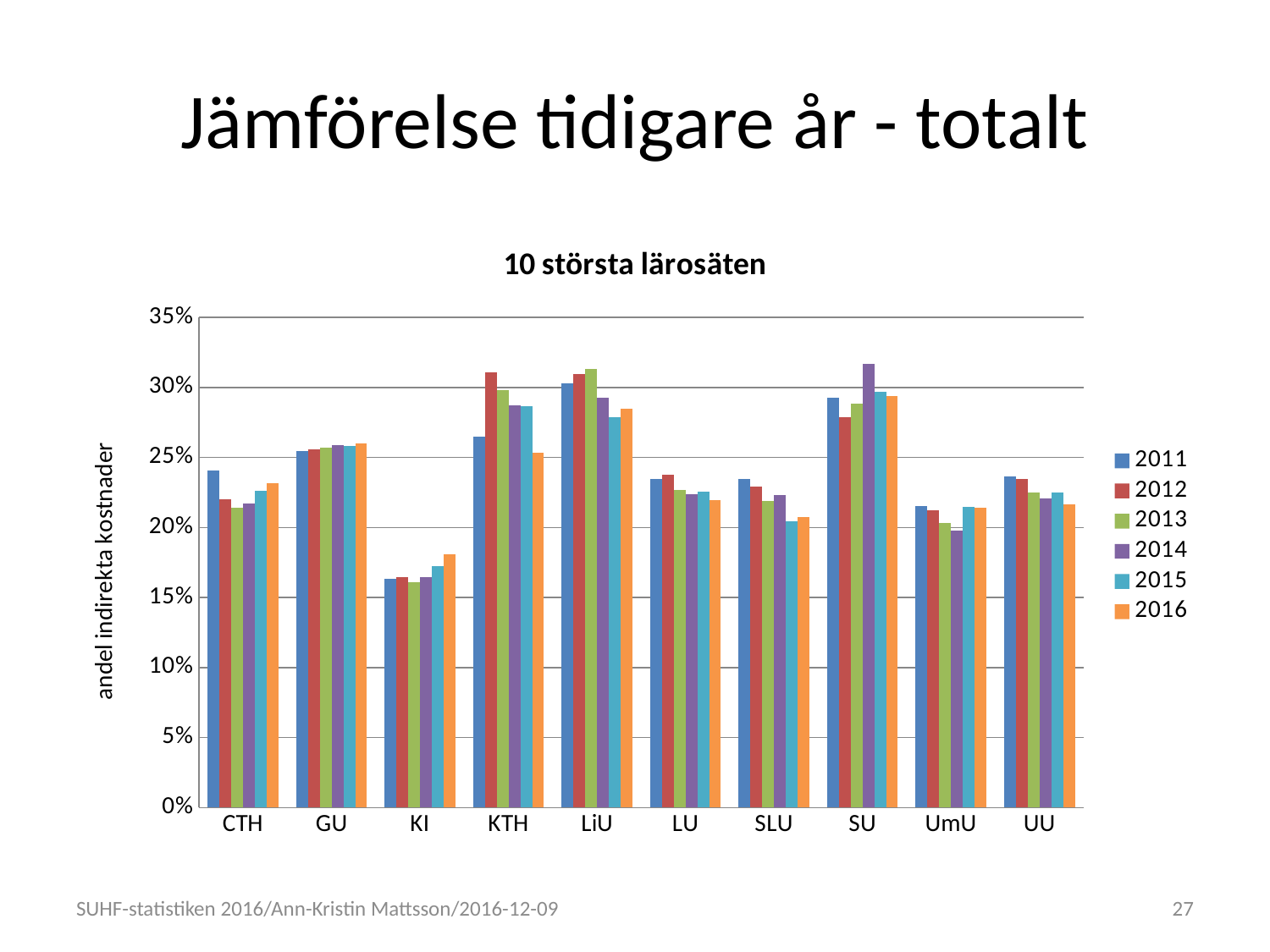
What kind of chart is shown on the slide? bar chart How many series does the legend list? 6 Which institution has the lowest values across all years? KI Do the values for KI generally rise or fall from 2011 to 2016? rise Is the value for CTH in 2011 greater or less than 25%? less Is the value for KI in 2016 greater or less than 20%? less How many institutions (categories) are shown on the x axis? 10 Which is larger for KTH: the 2012 value or the 2016 value? 2012 Which institution has the highest value for 2014? SU What is the title of the chart? 10 största lärosäten Is the value for LiU in 2015 greater or less than 30%? less